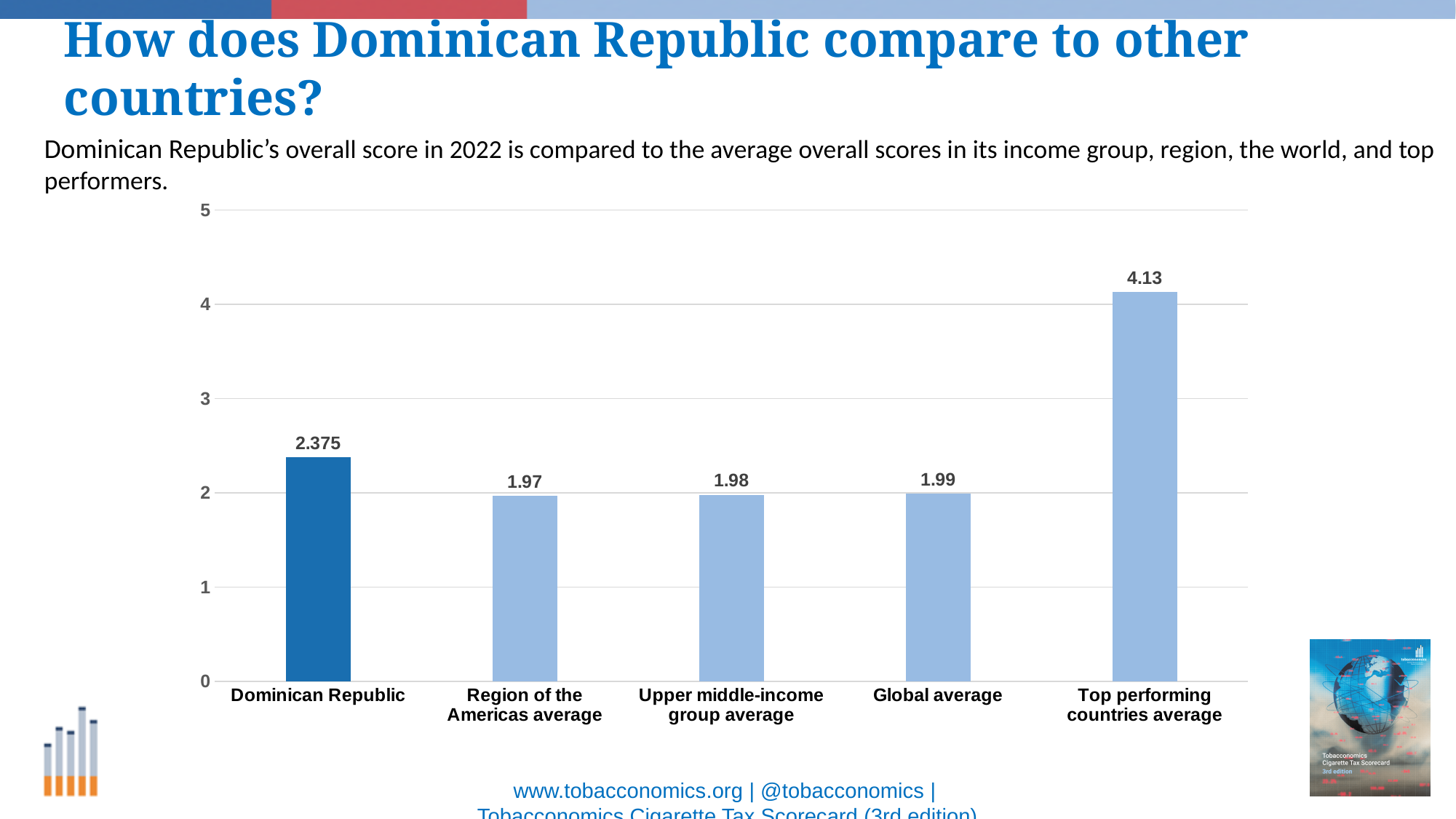
What is the value for Dominican Republic? 2.375 Which category has the lowest value? Region of the Americas average What is the difference between Dominican Republic and Global average? 0.385 What kind of chart is shown on the slide? Bar chart What is the value for Top performing countries average? 4.13 What is the value for Global average? 1.99 What is the difference between Top performing countries average and Dominican Republic? 1.755 Which is larger, Dominican Republic or Upper middle-income group average? Dominican Republic Which category has the highest value? Top performing countries average How many categories are shown in the chart? 5 What is the value for Region of the Americas average? 1.97 Is the value for Top performing countries average greater or less than 4? greater